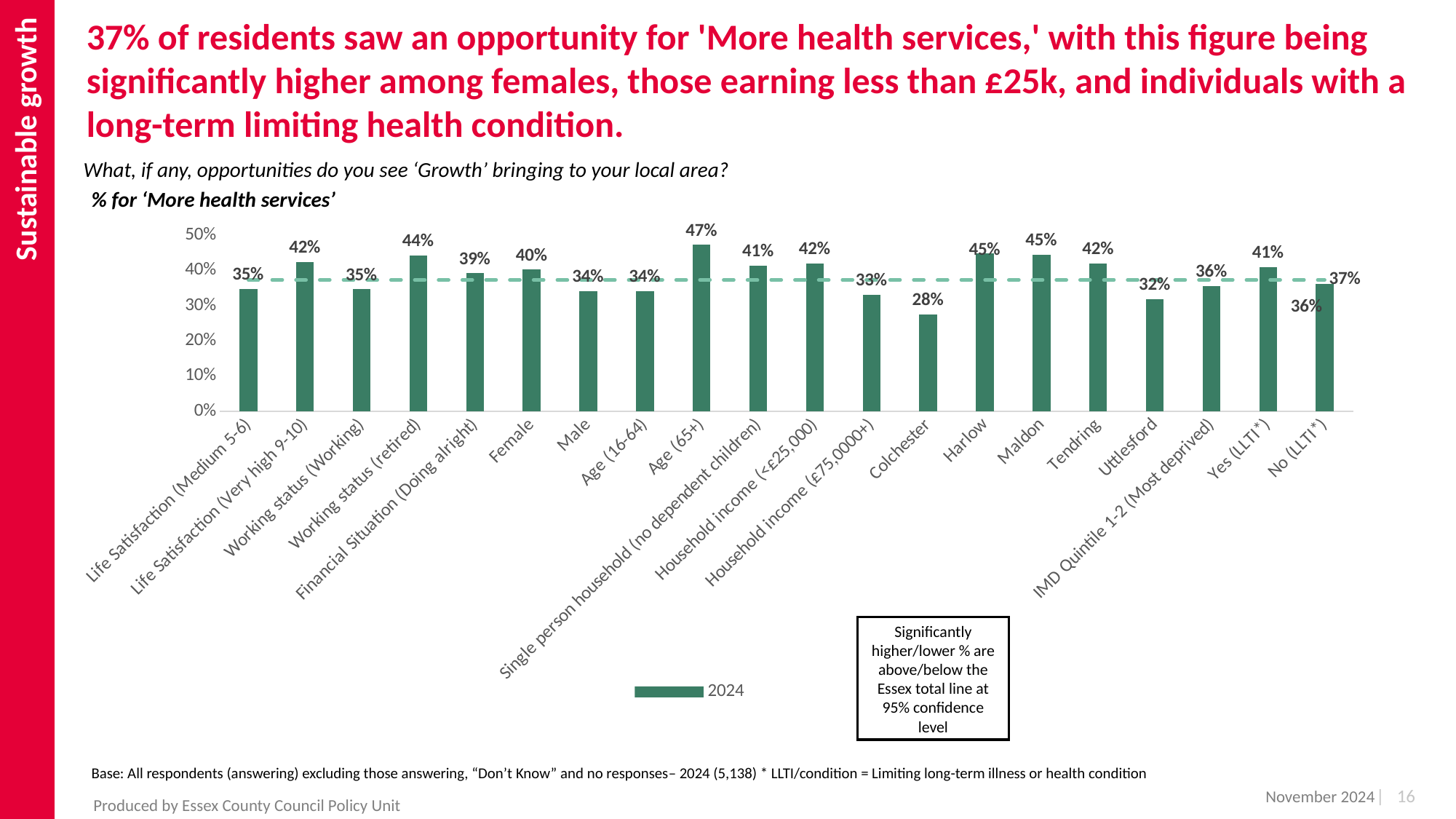
Which category has the lowest percentage for 'More health services'? Colchester What percentage is shown for Age (65+)? 47% How many categories (bars) are shown in the chart? 20 What type of chart is shown on the slide? Bar chart Which has a higher percentage, Harlow or Uttlesford? Harlow Which category has the highest percentage for 'More health services'? Age (65+) What percentage is shown for Female? 40% What is the difference in percentage points between Female and Male? 6 What percentage is shown for Colchester? 28% What percentage is shown for Household income (<£25,000)? 42% How many series does the legend list? 1 What is the difference in percentage points between Age (65+) and Colchester? 19